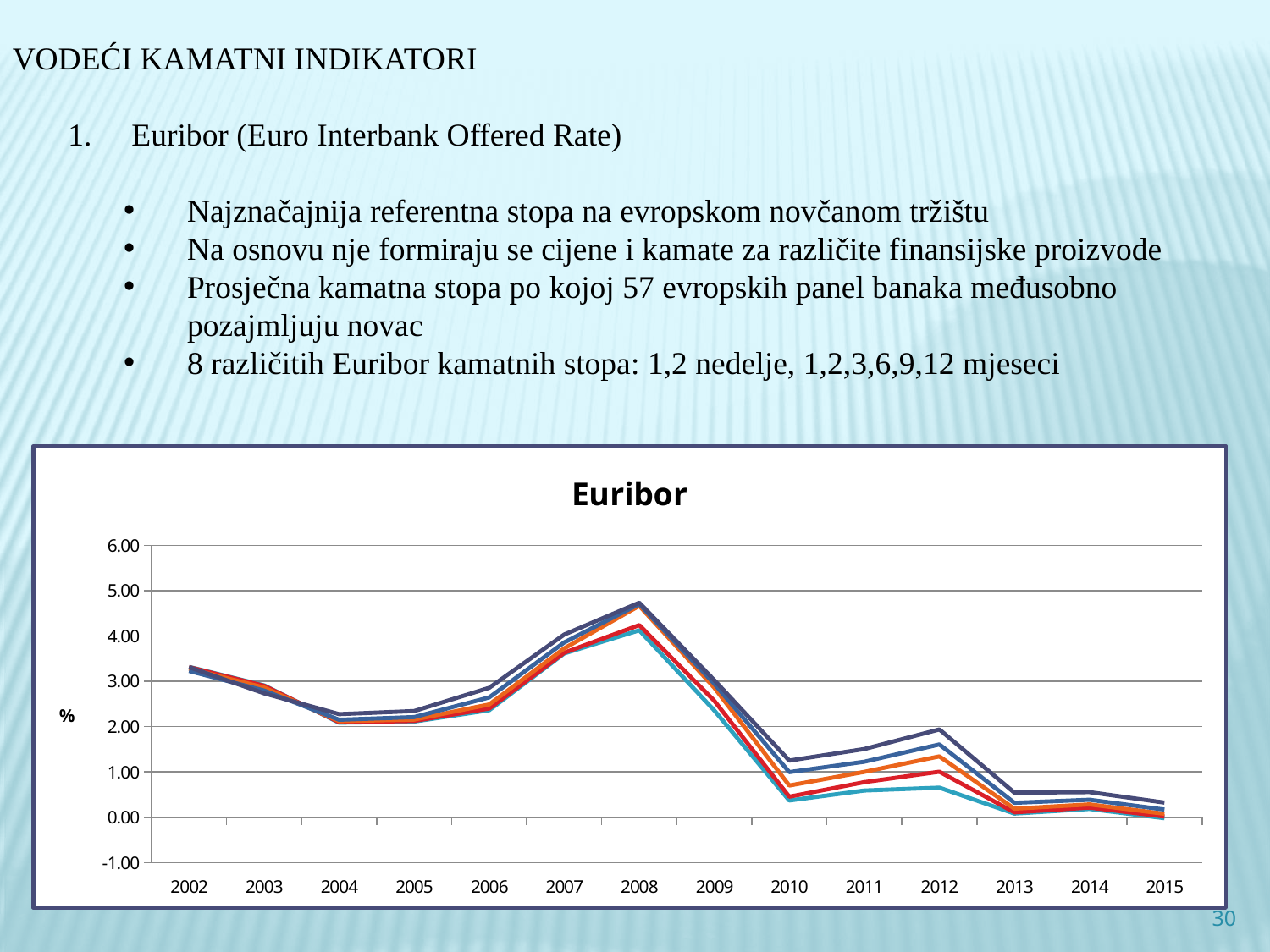
Do the Euribor values rise or fall between 2008 and 2010? fall What label is shown on the vertical axis of the chart? % Which year has higher Euribor values, 2008 or 2009? 2008 What kind of chart is shown on the slide? line chart Are the Euribor values in 2002 greater or less than 3.00? greater Are the Euribor values in 2015 greater or less than 1.00? less In which year do the Euribor lines reach their highest point? 2008 Are the Euribor values in 2008 greater or less than 3.00? greater How many years are shown along the x axis of the chart? 14 What is the title of the chart? Euribor In which year do the Euribor lines reach their lowest point? 2015